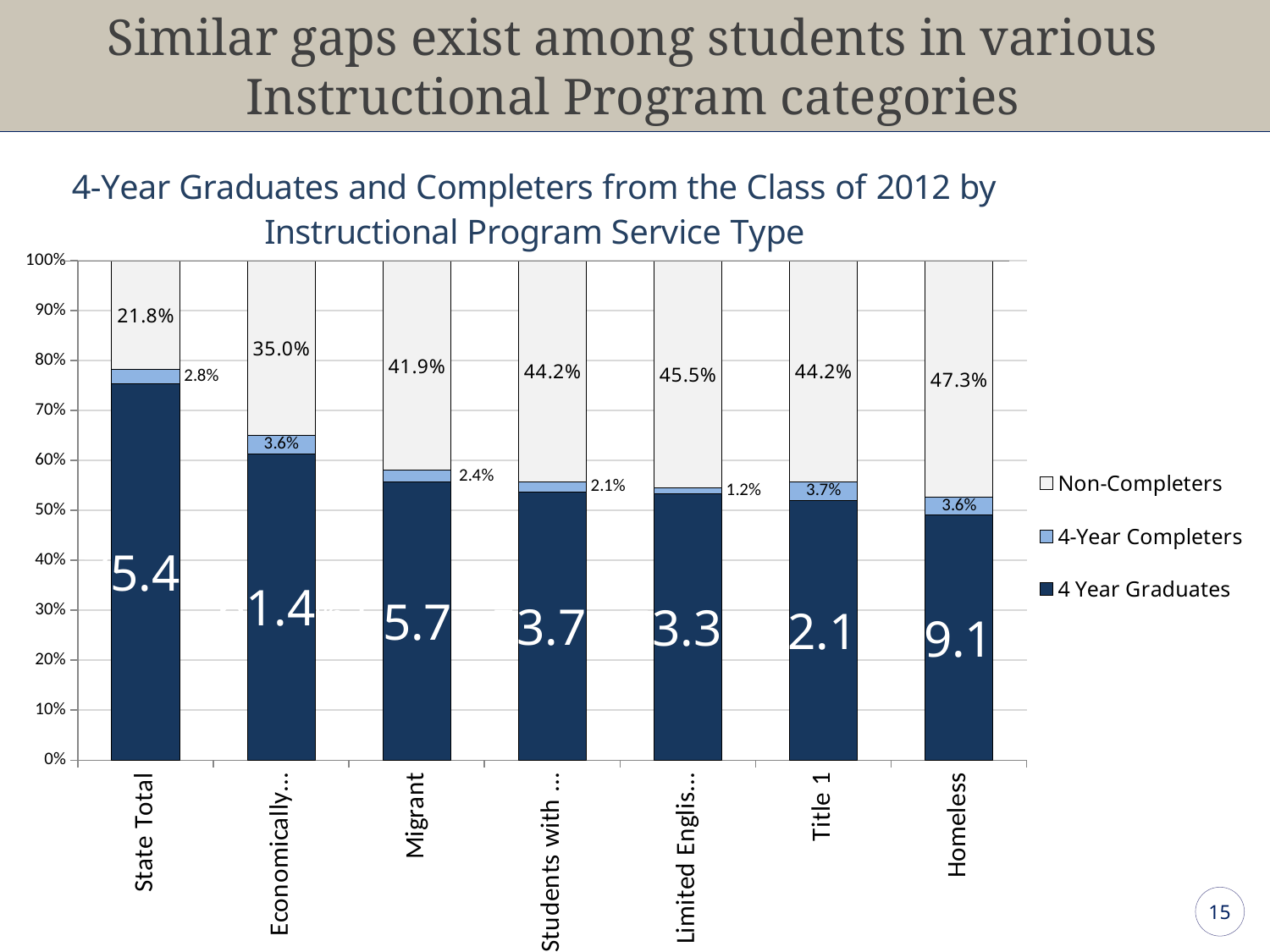
What is the 4-Year Completers value for Title 1? 3.7% How many categories are shown along the x axis? 7 Which category has the lowest Non-Completers value? State Total What is the difference between the Non-Completers value for Homeless and for State Total? 25.5 percentage points Which has a larger Non-Completers value, Migrant or Economically...? Migrant Which category has the highest Non-Completers value? Homeless What is the Non-Completers value for State Total? 21.8% What is the Non-Completers value for Homeless? 47.3% Is the 4 Year Graduates value for State Total greater or less than 70%? greater How many series does the legend list? 3 What type of chart is shown on the slide? Stacked bar chart What is the 4-Year Completers value for Migrant? 2.4%